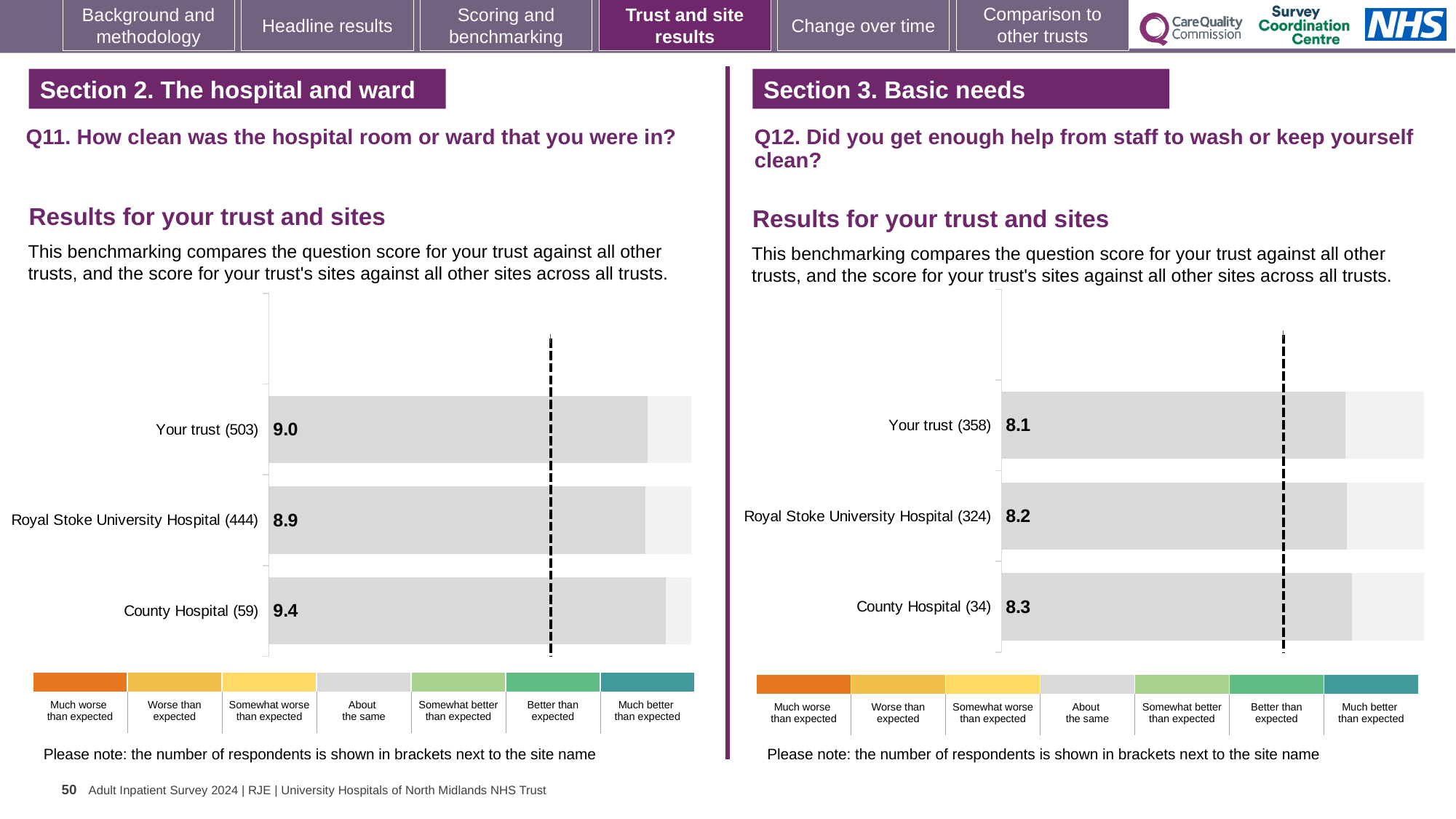
On the Q12 chart (right), what is the difference between the County Hospital score and the Your trust score? 0.2 What type of chart is used on the Q11 chart (left)? Bar chart On the Q11 chart (left), which site or trust has the lowest score? Royal Stoke University Hospital On the Q12 chart (right), what is the score for Royal Stoke University Hospital? 8.2 Is the Your trust score higher on the Q11 chart (left) or the Q12 chart (right)? Q11 chart (left) On the Q11 chart (left), how many bars are plotted? 3 On the Q12 chart (right), what is the score for Your trust? 8.1 On the Q12 chart (right), which site or trust has the highest score? County Hospital On the Q11 chart (left), what is the difference between the County Hospital score and the Royal Stoke University Hospital score? 0.5 On the Q11 chart (left), which site or trust has the highest score? County Hospital On the Q11 chart (left), what is the score for County Hospital? 9.4 On the Q11 chart (left), what is the score for Your trust? 9.0